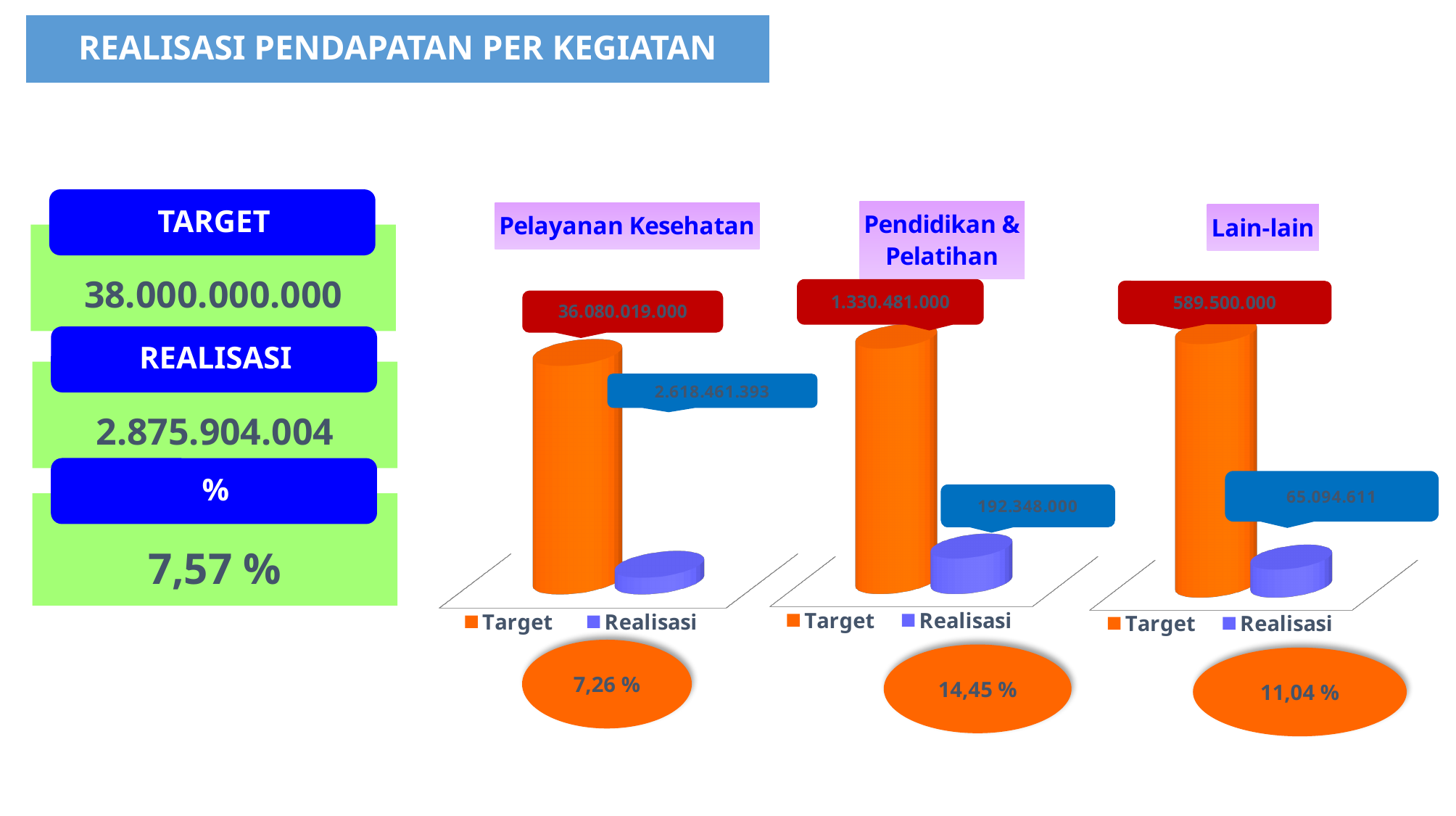
In the Lain-lain chart, what is the Target value? 589.500.000 In the Pendidikan & Pelatihan chart, what is the Realisasi value? 192.348.000 In the Lain-lain chart, which series is larger, Target or Realisasi? Target In the Pelayanan Kesehatan chart, what is the Realisasi value? 2.618.461.393 In the Pelayanan Kesehatan chart, what is the Target value? 36.080.019.000 In the Pendidikan & Pelatihan chart, what is the difference between Target and Realisasi? 1.138.133.000 In the Lain-lain chart, what is the difference between Target and Realisasi? 524.405.389 In the Pelayanan Kesehatan chart, what colour represents the Realisasi series? Blue/purple In the Pendidikan & Pelatihan chart, what is the Target value? 1.330.481.000 In the Lain-lain chart, what is the Realisasi value? 65.094.611 What type of chart is used for Pendidikan & Pelatihan? Bar chart How many series does the legend of the Pelayanan Kesehatan chart list? 2